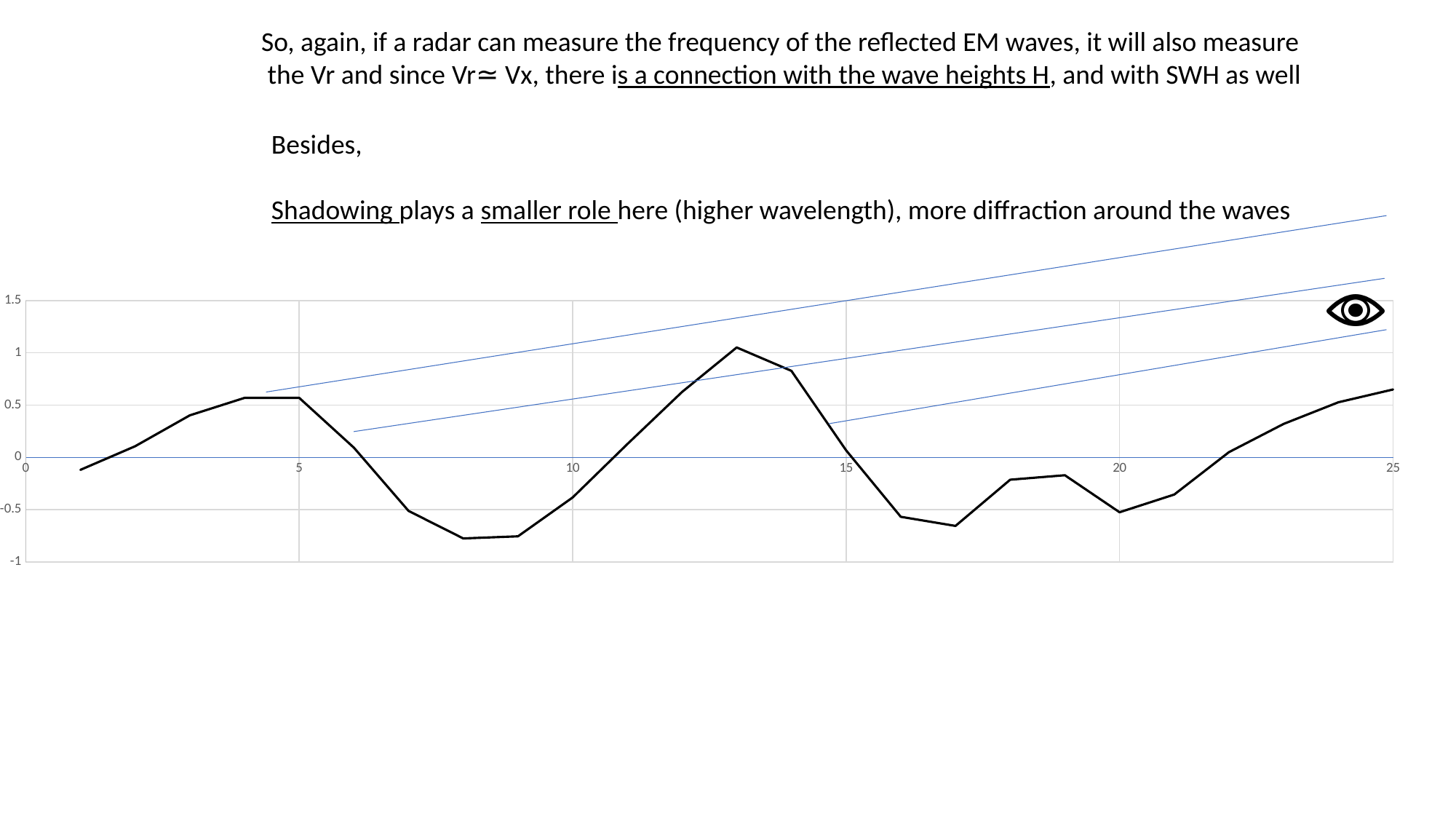
What is the highest value labelled on the y axis? 1.5 Is the value of the black line at x = 25 greater or less than 0.5? greater Is the value of the black line at x = 8 greater or less than -0.5? less Does the black line rise or fall between x = 5 and x = 8? fall Is the value of the black line at x = 13 greater or less than 0.5? greater Around which x value does the black line reach its lowest point? 8 Which is larger, the value of the black line at x = 13 or at x = 4? x = 13 What kind of chart is shown on the slide? line chart Around which x value does the black line reach its highest point? 13 Does the black line rise or fall between x = 8 and x = 13? rise